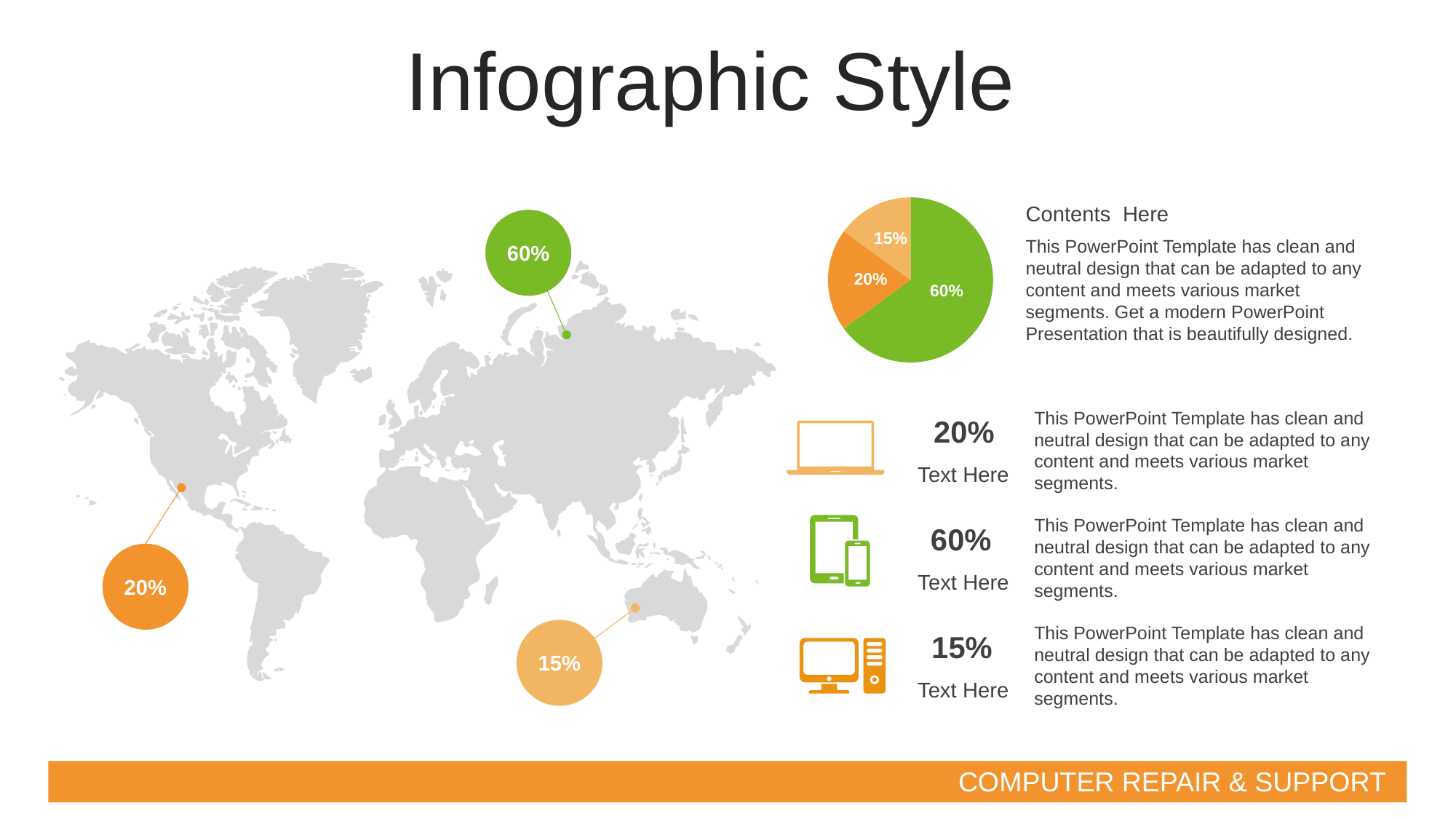
What colour is the 60% slice of the pie chart? green What value is shown on the light orange slice of the pie chart? 15% How many slices does the pie chart have? 3 What value is shown on the dark orange slice of the pie chart? 20% What value is shown on the green slice of the pie chart? 60% What is the difference between the largest and smallest slices of the pie chart? 45% Does the pie chart have a legend? No Which slice of the pie chart is the smallest? the light orange slice (15%) What is the difference between the green slice and the dark orange slice of the pie chart? 40% What kind of chart is shown on the slide? pie chart Which is larger in the pie chart, the dark orange slice or the light orange slice? the dark orange slice Which slice of the pie chart is the largest? the green slice (60%)